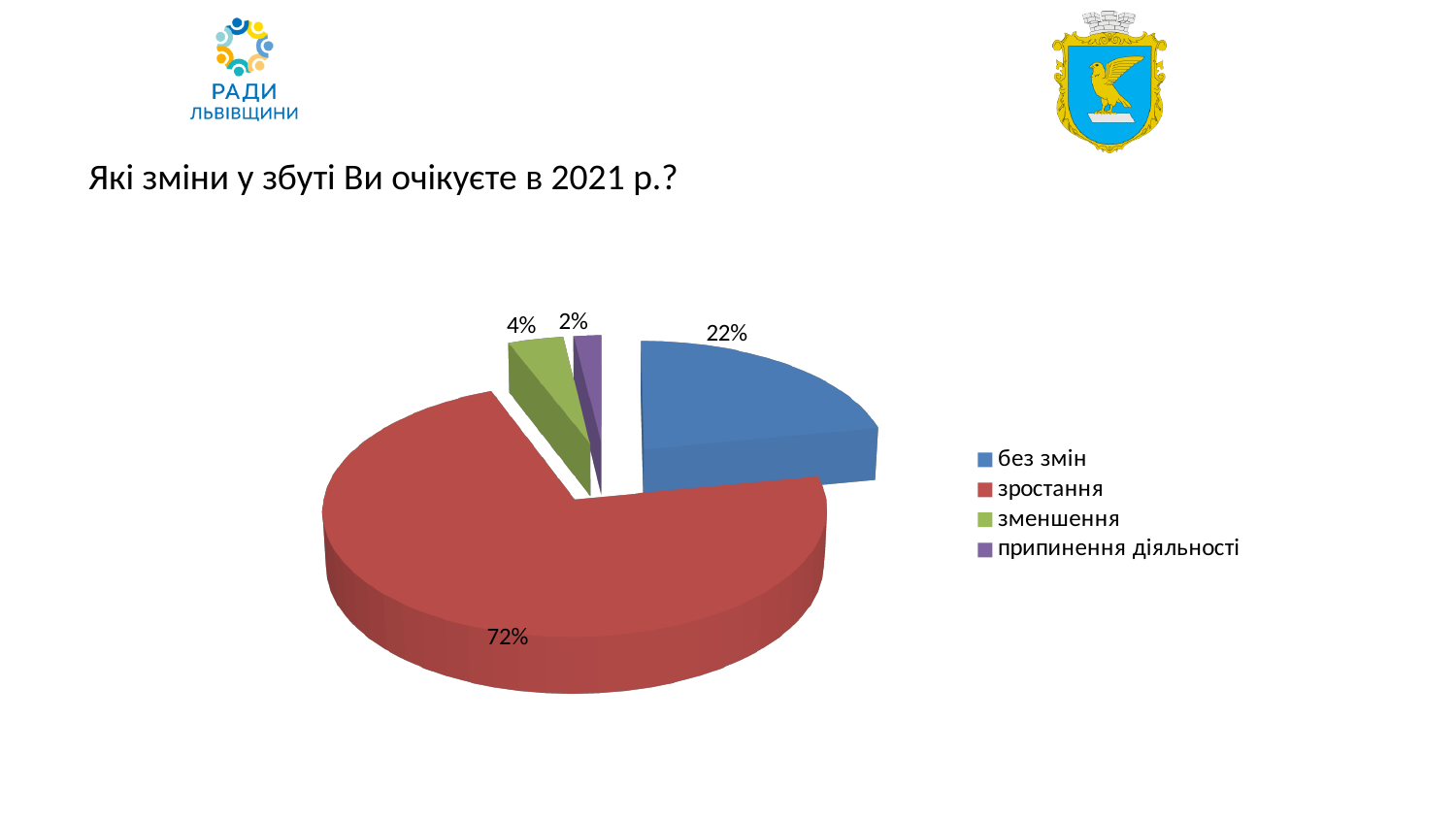
What share of the pie does "зростання" take? 72% Which is larger, the slice for "зменшення" or the slice for "припинення діяльності"? зменшення Which category has the smallest slice of the pie? припинення діяльності What share of the pie does "припинення діяльності" take? 2% How many slices does the pie chart have? 4 What share of the pie does "без змін" take? 22% What kind of chart is shown on the slide? pie chart What share of the pie does "зменшення" take? 4% Which category has the largest slice of the pie? зростання What is the difference in percentage points between "зростання" and "без змін"? 50 What is the title of the slide above the chart? Які зміни у збуті Ви очікуєте в 2021 р.? What colour is the slice for "зростання"? red